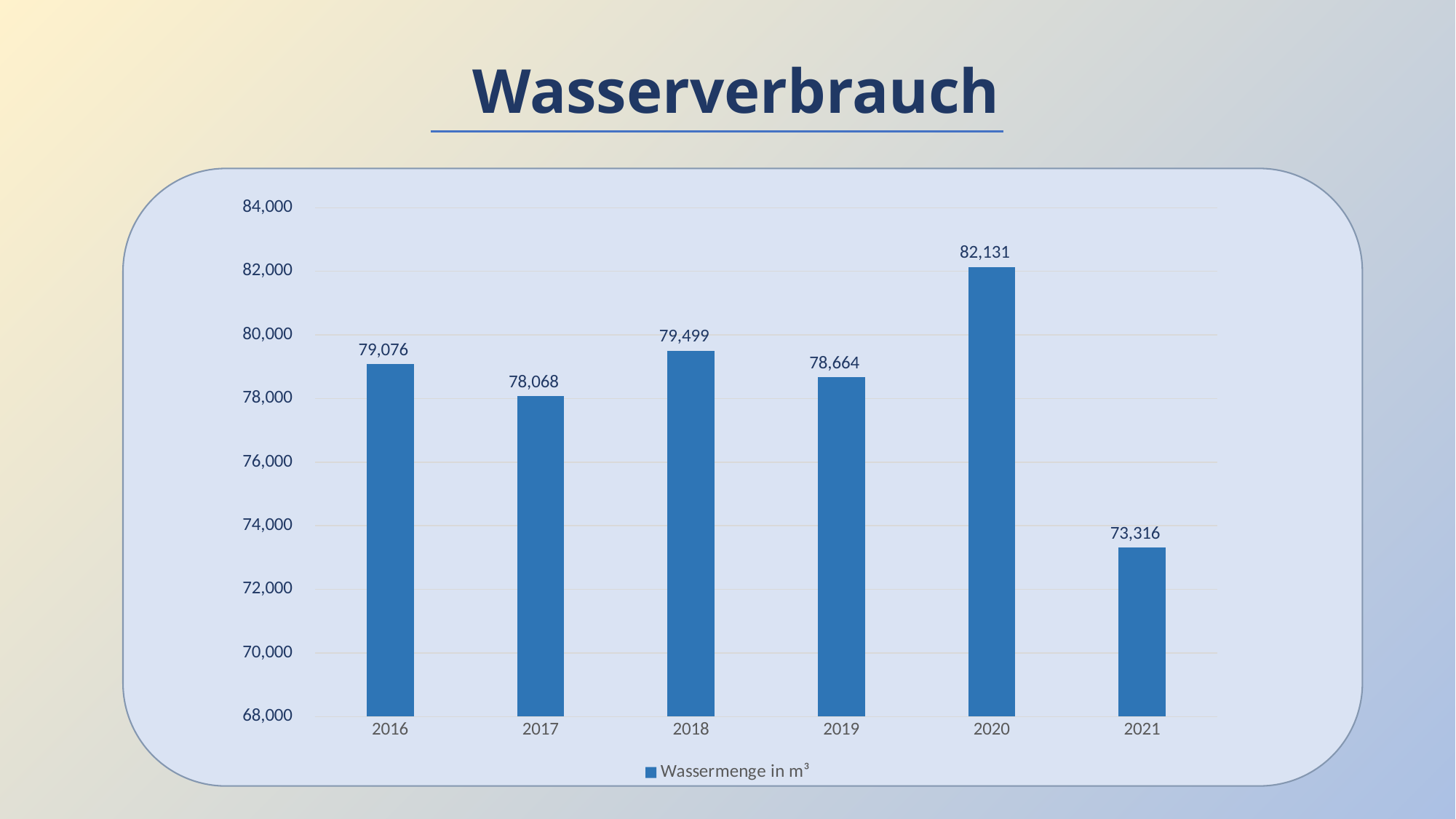
What is the value shown for 2020? 82,131 What is the value shown for 2021? 73,316 What is the difference between the values for 2018 and 2017? 1,431 Which year has a larger value, 2016 or 2019? 2016 What kind of chart is shown on the slide? bar chart What is the legend entry for the series? Wassermenge in m³ How many years are shown on the x axis? 6 Which year has the highest water consumption? 2020 Is the value for 2021 greater or less than 74,000? less What is the difference between the values for 2020 and 2021? 8,815 What is the water consumption value for 2016? 79,076 Which year has the lowest water consumption? 2021